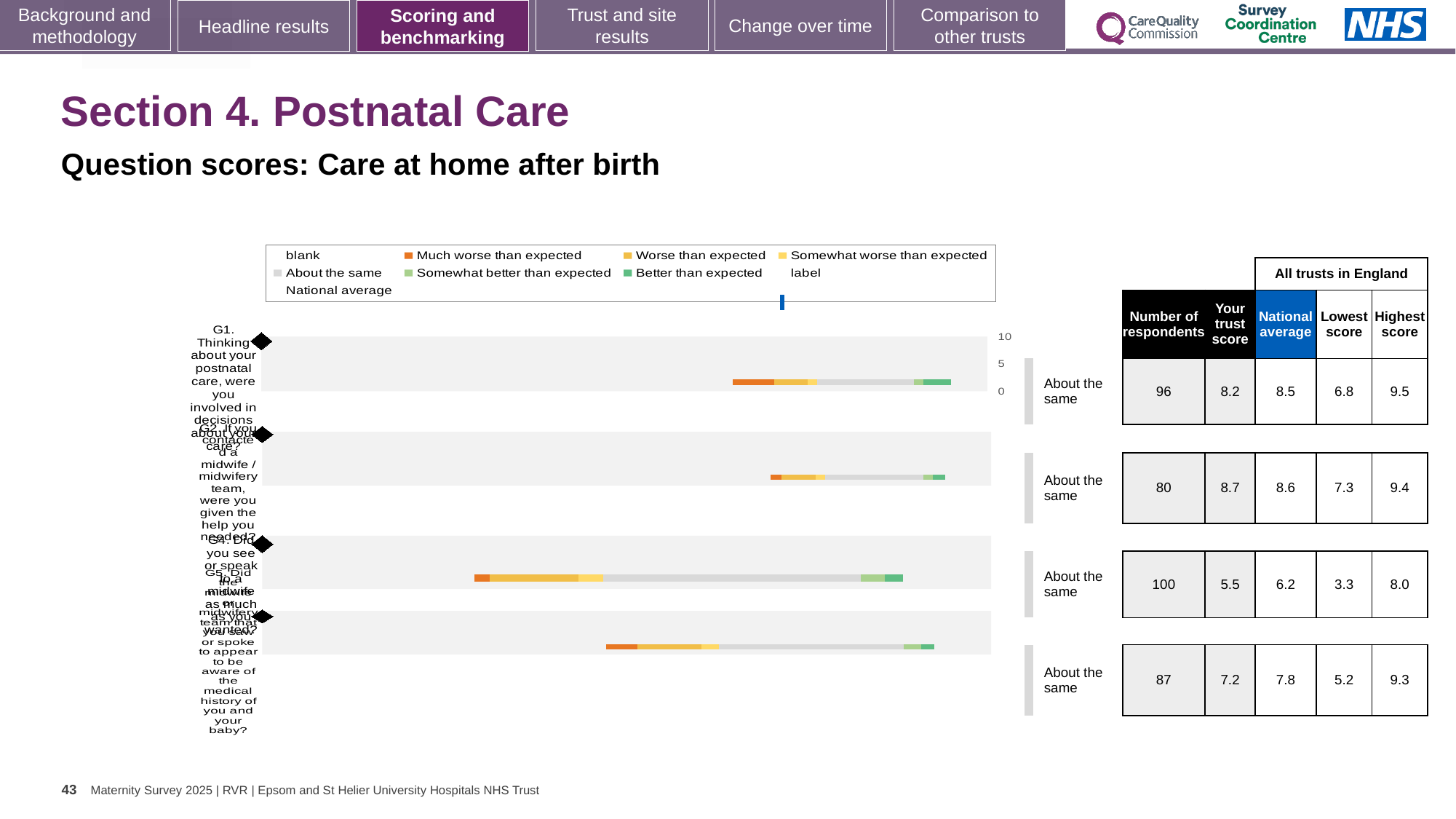
How many question bars are plotted in the chart? 4 Which question has the lowest trust score in the table beside the chart? G4 Which question has the highest trust score in the table beside the chart? G2 What kind of chart is shown on the slide? bar chart In the table beside the chart, what is the number of respondents for question G1? 96 In the table beside the chart, what is the trust score for question G4? 5.5 Is the trust score for question G4 larger or smaller than the national average for G4? smaller Which colour does the legend use for 'Better than expected'? green In the table beside the chart, what is the national average for question G2? 8.6 What is the difference between the national average and the trust score for question G1? 0.3 Which colour does the legend use for 'Much worse than expected'? orange In the table beside the chart, what is the highest score in England for question G5? 9.3